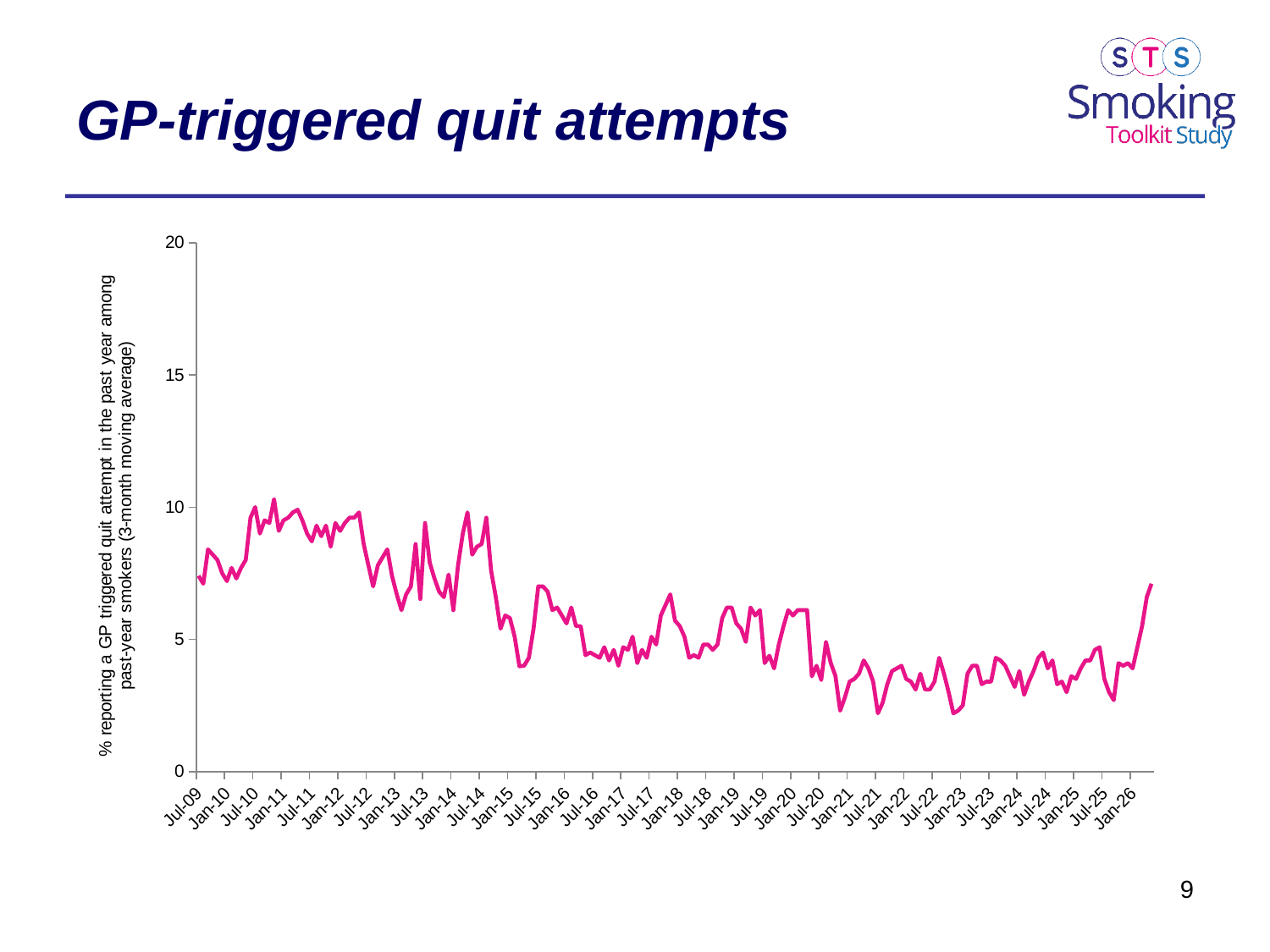
What is the title of the slide's chart? GP-triggered quit attempts Is the value at Jul-21 greater or less than 5? less Overall, do the values rise or fall from Jul-09 to Jan-26? fall What does the y-axis of the chart measure? % reporting a GP triggered quit attempt in the past year among past-year smokers (3-month moving average) Which is larger, the value at Jul-22 or the value at Jul-10? Jul-10 Which is larger, the value at Jan-11 or the value at Jan-21? Jan-11 How many lines are plotted on the chart? 1 Is the value at Jan-11 greater or less than 5? greater Is the value at Jan-11 greater or less than 15? less What kind of chart is shown on the slide? line chart